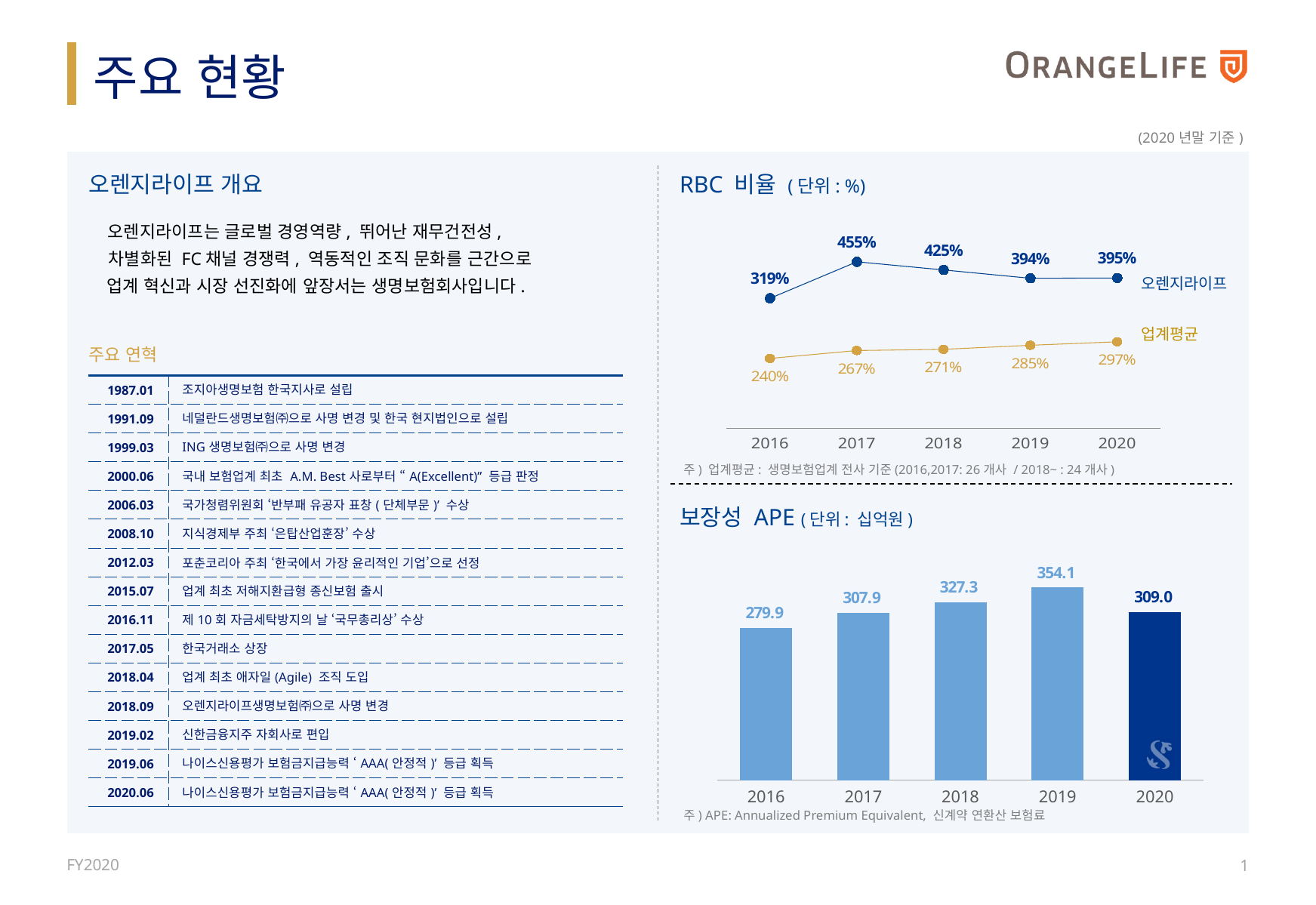
In the RBC 비율 chart, which year has the lowest 업계평균 value? 2016 In the RBC 비율 chart, what is the 업계평균 value for 2020? 297% In the 보장성 APE chart, what is the difference between the 2019 and 2020 values? 45.1 In the RBC 비율 chart, does the 업계평균 series rise or fall from 2016 to 2020? rise In the RBC 비율 chart, what is the difference between the 오렌지라이프 and 업계평균 values in 2016? 79% In the RBC 비율 chart, which year has the highest 오렌지라이프 value? 2017 In the RBC 비율 chart, how many series are shown? 2 In the 보장성 APE chart, which year has the lowest value? 2016 In the RBC 비율 chart, what is the 오렌지라이프 value for 2017? 455% What kind of chart is the 보장성 APE chart? bar chart In the 보장성 APE chart, which is larger, the value for 2017 or the value for 2020? 2020 In the 보장성 APE chart, what is the value for 2019? 354.1